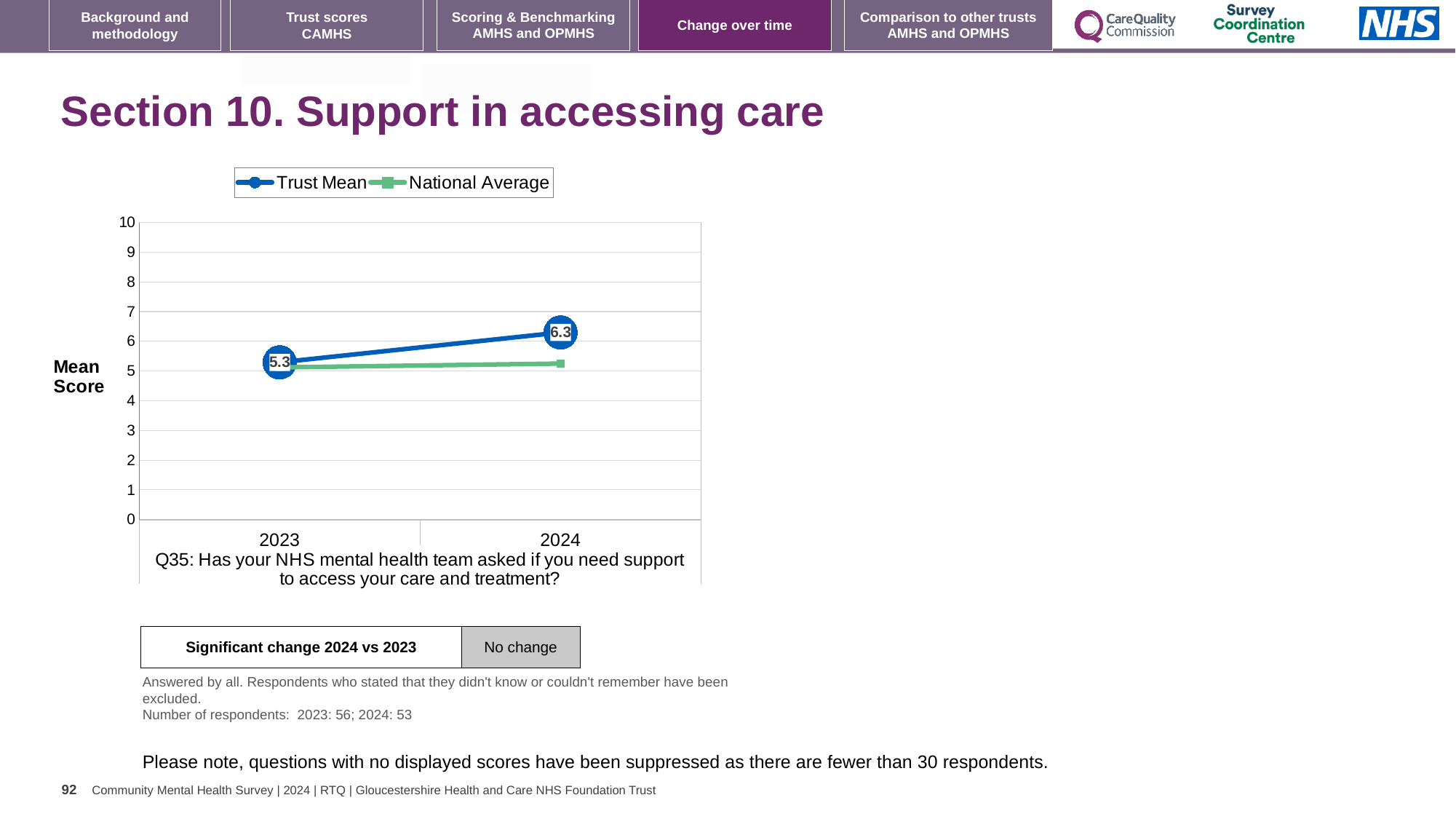
Is the National Average value for 2024 greater or less than 6? less In 2024, which is higher, the Trust Mean or the National Average? Trust Mean Which year has the higher Trust Mean score, 2023 or 2024? 2024 By how much did the Trust Mean change from 2023 to 2024? 1.0 What is the label on the y axis of the chart? Mean Score What is the Trust Mean score for 2023? 5.3 What kind of chart is shown on the slide? line chart How many series does the chart legend list? 2 Does the Trust Mean rise or fall from 2023 to 2024? rises What is the Trust Mean score for 2024? 6.3 How many years are plotted on the x axis of the chart? 2 Is the National Average value for 2023 greater or less than 4? greater